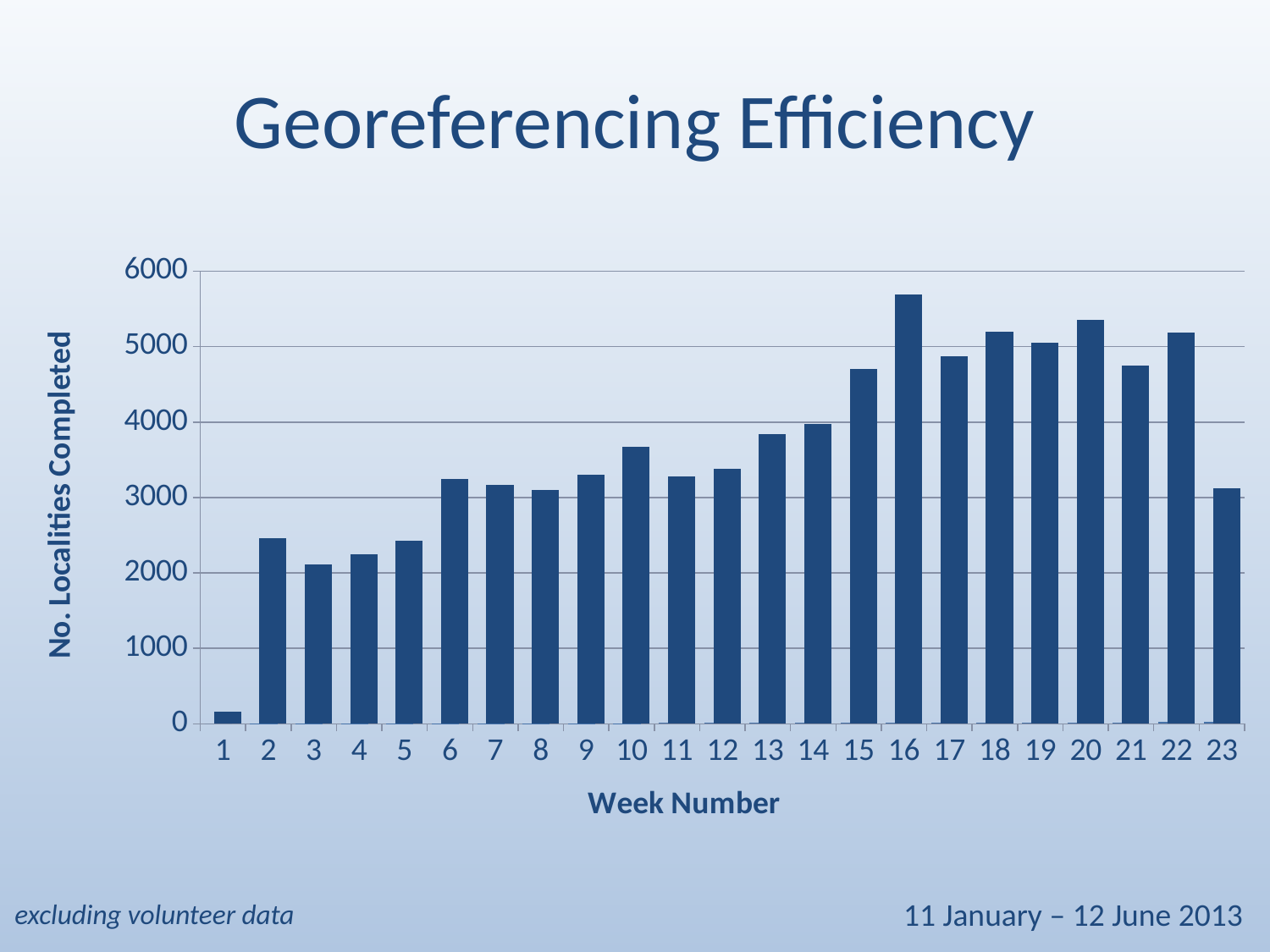
Do the values generally rise or fall from week 1 to week 16? rise Is the value for week 1 greater or less than 1000? less Is the value for week 10 greater or less than 3000? greater Which week has the lowest number of localities completed? 1 What kind of chart is shown on the slide? bar chart Is the value for week 15 greater or less than 5000? less Which week has the highest number of localities completed? 16 What is the label of the y axis? No. Localities Completed How many weeks are plotted on the x axis? 23 What is the title of the chart? Georeferencing Efficiency Which is larger, the value for week 16 or the value for week 23? week 16